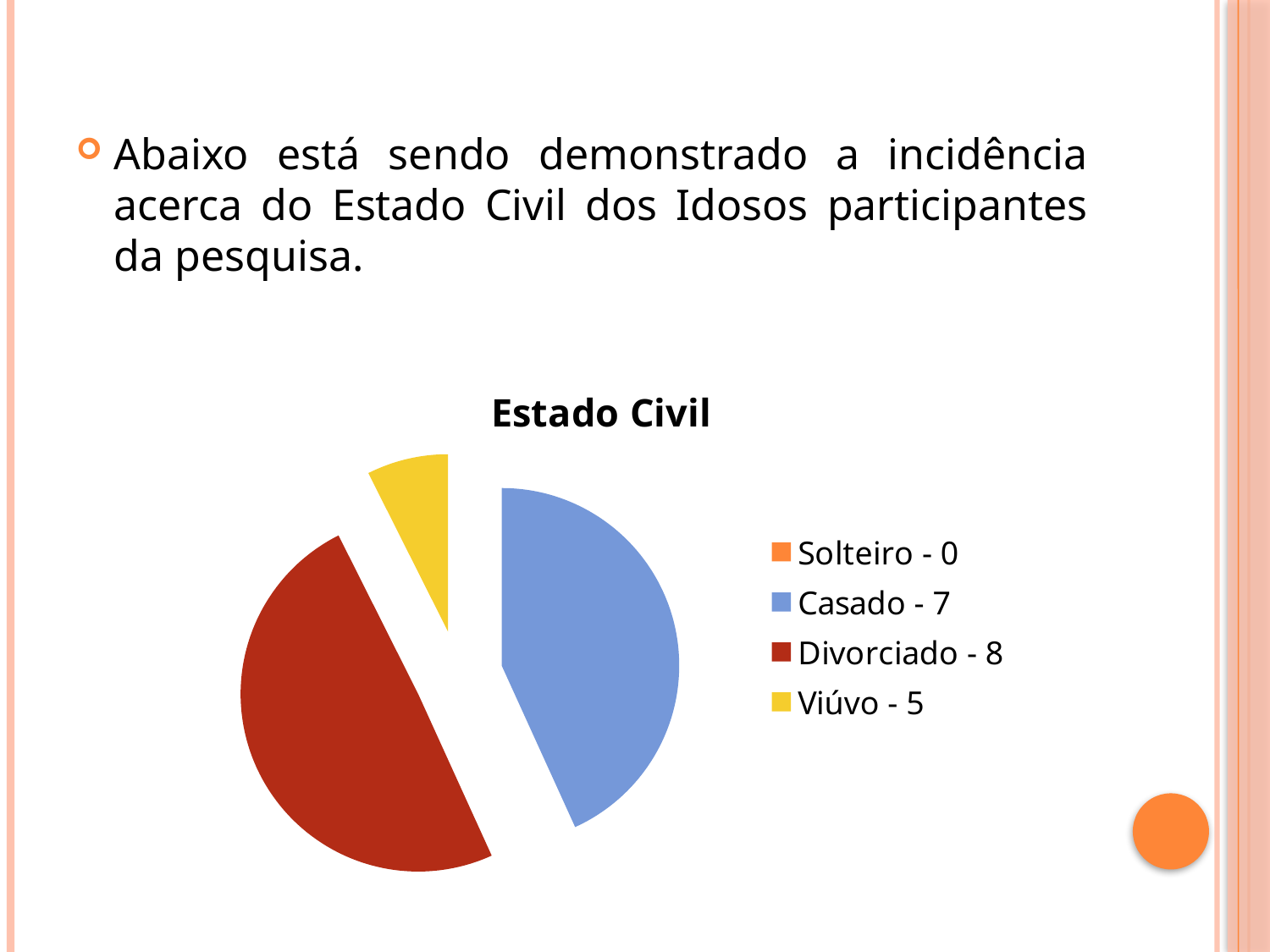
What is the title of the chart? Estado Civil What is the difference between the values for Divorciado and Viúvo? 3 Which is larger, the value for Casado or the value for Viúvo? Casado What is the value for Viúvo? 5 What kind of chart is shown on the slide? pie chart Which category has the highest value? Divorciado What is the value for Solteiro? 0 Which category has the lowest value? Solteiro What is the value for Casado? 7 What is the value for Divorciado? 8 How many entries does the chart's legend list? 4